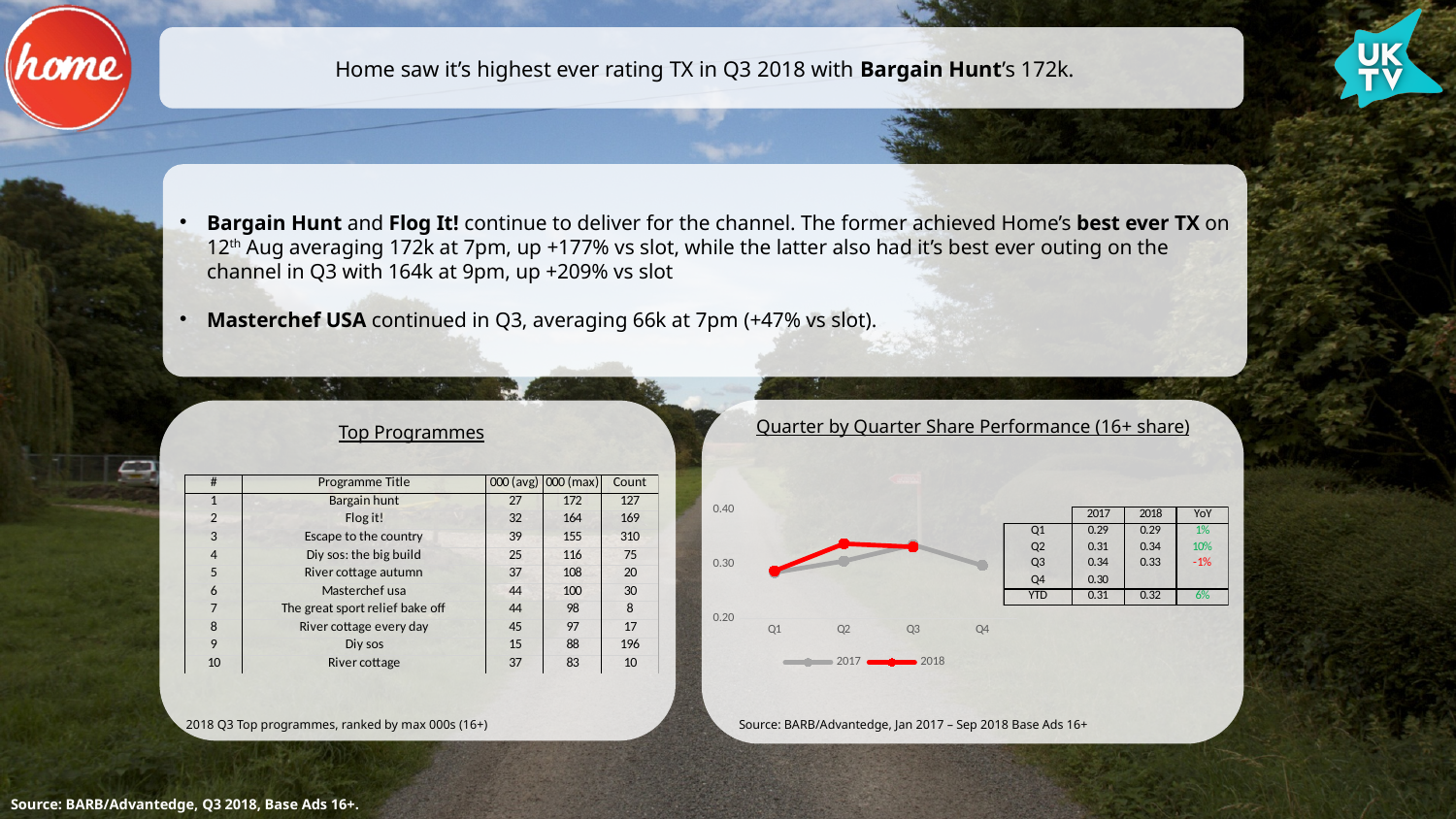
How many series does the legend of the Quarter by Quarter Share Performance chart list? 2 What kind of chart is the Quarter by Quarter Share Performance chart? line chart In the Quarter by Quarter Share Performance chart, what is the difference between the 2018 and 2017 shares in Q2? 0.03 In the Quarter by Quarter Share Performance chart, what is the 2017 share for Q3? 0.34 In the Quarter by Quarter Share Performance chart, is the 2018 share for Q2 greater or less than 0.30? greater In the Quarter by Quarter Share Performance chart, which quarter has the lowest 2017 share? Q1 Which series are listed in the legend of the Quarter by Quarter Share Performance chart? 2017 and 2018 In the Quarter by Quarter Share Performance chart, which quarter has the highest 2018 share? Q2 In the Quarter by Quarter Share Performance chart, what is the 2018 share for Q2? 0.34 In the Quarter by Quarter Share Performance chart, what is the 2017 share for Q4? 0.30 How many quarters are shown on the x axis of the Quarter by Quarter Share Performance chart? 4 In the Quarter by Quarter Share Performance chart, does the 2017 series rise or fall from Q1 to Q3? rise